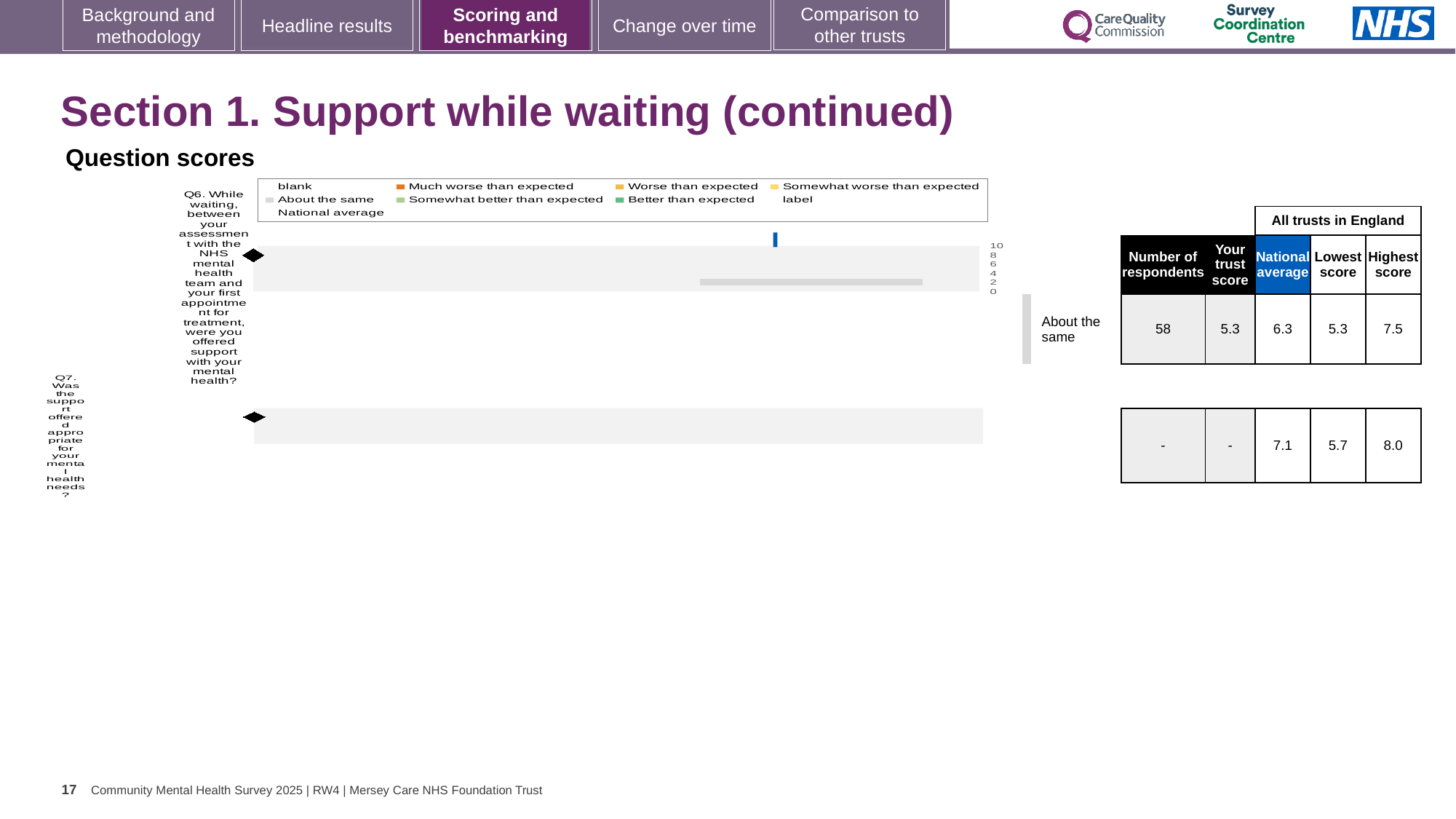
For Q6, which is larger: the trust score or the national average? national average What kind of chart is used to show the question scores? bar chart What is the national average for Q6? 6.3 What is the highest score across all trusts in England for Q6? 7.5 What is the difference between the national average and the trust score for Q6? 1.0 What benchmark category is shown for Q6? About the same How many respondents answered Q6? 58 What is the lowest score across all trusts in England for Q7? 5.7 What is the trust score for Q6? 5.3 What is the national average for Q7? 7.1 How many questions are plotted on the chart? 2 What is the highest score across all trusts in England for Q7? 8.0